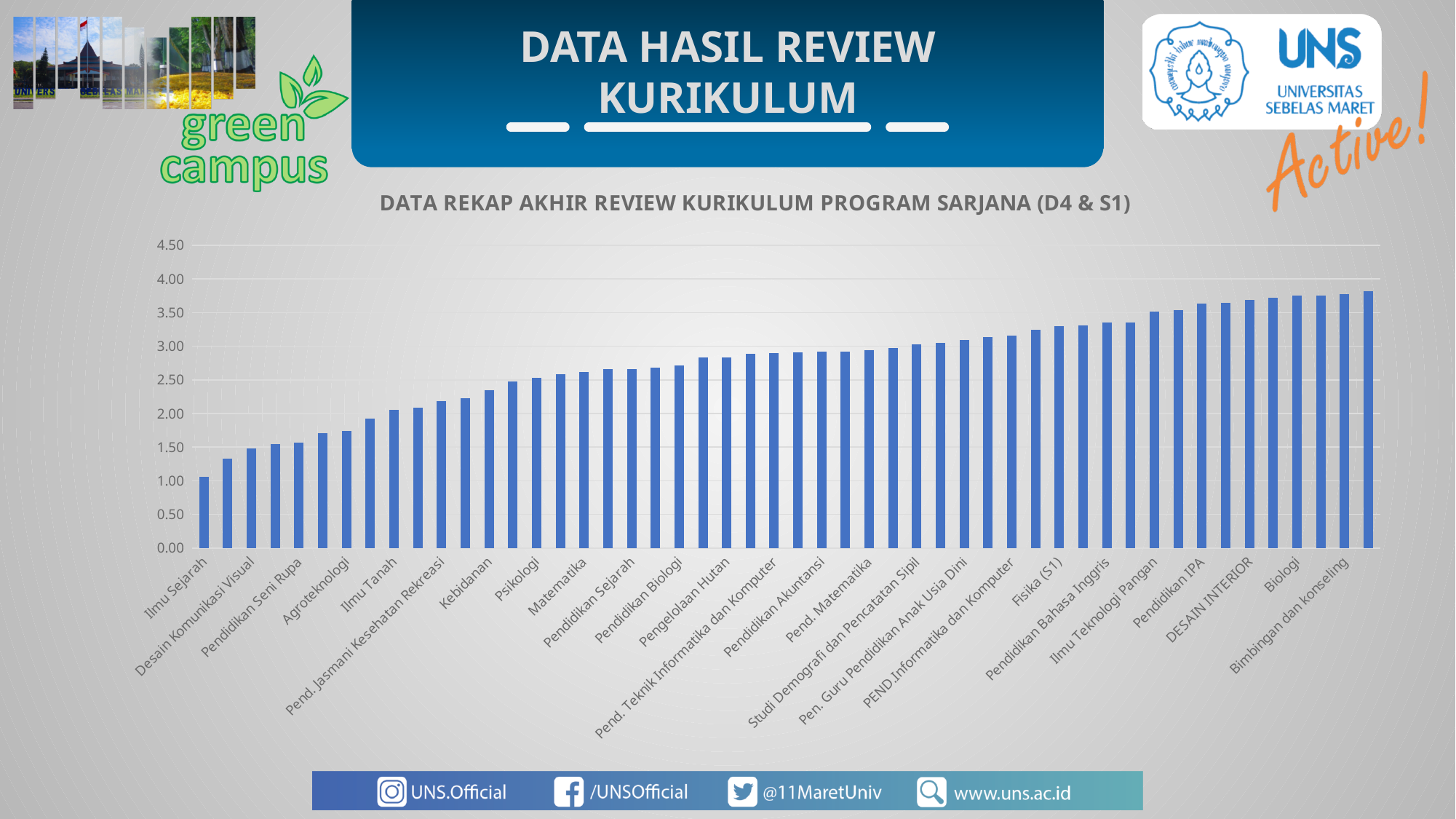
What kind of chart is shown on the slide? bar chart Is the value for Agroteknologi greater or less than 2.00? less What is the title of the chart? DATA REKAP AKHIR REVIEW KURIKULUM PROGRAM SARJANA (D4 & S1) Which program has the lowest value in the chart? Ilmu Sejarah Is the value for Kebidanan greater or less than 2.50? less Is the value for Bimbingan dan konseling greater or less than 3.50? greater Which has the larger value, Matematika or Fisika (S1)? Fisika (S1) Which has the larger value, Biologi or Ilmu Tanah? Biologi Do the values rise or fall moving from left to right along the x axis? rise